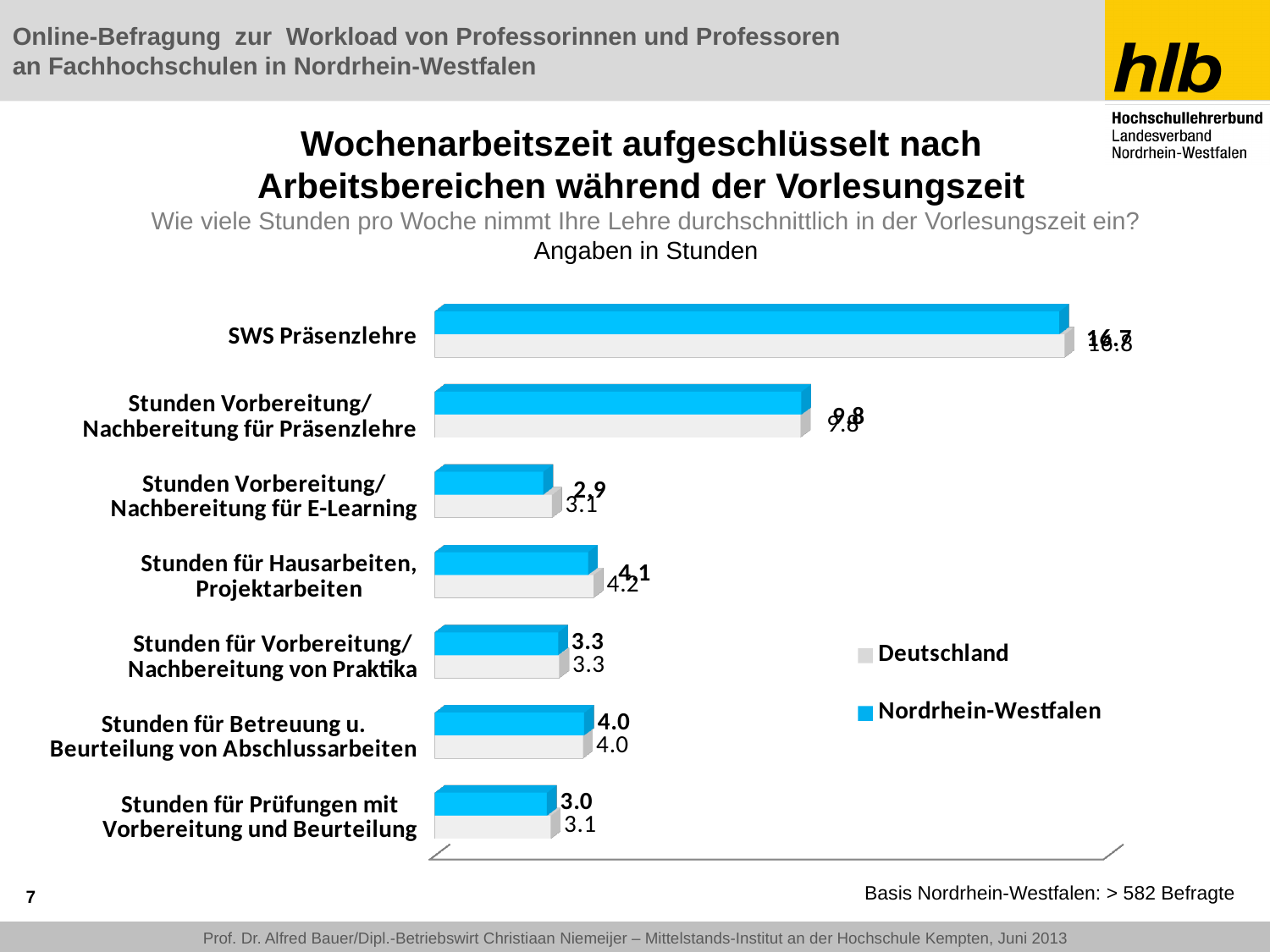
Which colour represents Nordrhein-Westfalen in the chart? blue What is the difference between the Deutschland and Nordrhein-Westfalen values for 'Stunden Vorbereitung/Nachbereitung für E-Learning'? 0.2 What is the value for Deutschland for 'Stunden für Betreuung u. Beurteilung von Abschlussarbeiten'? 4.0 What is the value for Nordrhein-Westfalen for 'Stunden für Vorbereitung/Nachbereitung von Praktika'? 3.3 What is the value for Deutschland for 'Stunden für Prüfungen mit Vorbereitung und Beurteilung'? 3.1 What is the value for Nordrhein-Westfalen for 'Stunden für Prüfungen mit Vorbereitung und Beurteilung'? 3.0 What kind of chart is shown on the slide? bar chart How many categories (Arbeitsbereiche) are shown in the chart? 7 What is the value for Nordrhein-Westfalen for 'Stunden Vorbereitung/Nachbereitung für E-Learning'? 2.9 How many series does the legend list? 2 Which category has the highest values in the chart? SWS Präsenzlehre For Nordrhein-Westfalen, which is larger: 'Stunden für Betreuung u. Beurteilung von Abschlussarbeiten' or 'Stunden für Prüfungen mit Vorbereitung und Beurteilung'? Stunden für Betreuung u. Beurteilung von Abschlussarbeiten